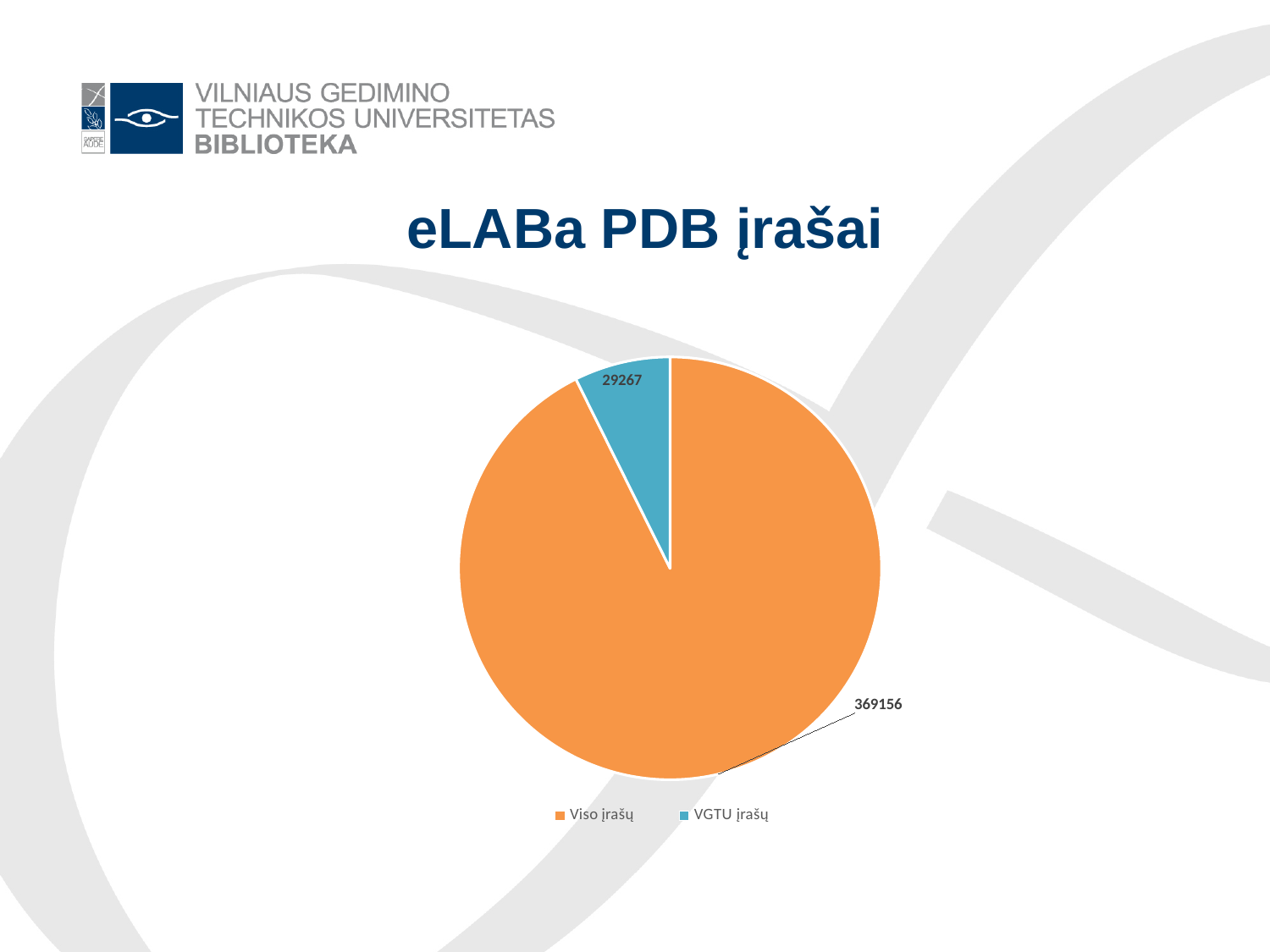
Which category has the smallest slice of the pie? VGTU įrašų What is the value for Viso įrašų? 369156 Which category has the largest slice of the pie? Viso įrašų What is the value for VGTU įrašų? 29267 What is the total of the two slices in the pie chart? 398423 What is the title of the chart? eLABa PDB įrašai How many slices does the pie chart have? 2 What is the difference between the value for Viso įrašų and the value for VGTU įrašų? 339889 What kind of chart is shown on the slide? pie chart Which is larger, Viso įrašų or VGTU įrašų? Viso įrašų How many entries does the legend list? 2 What colour is the slice for VGTU įrašų? blue